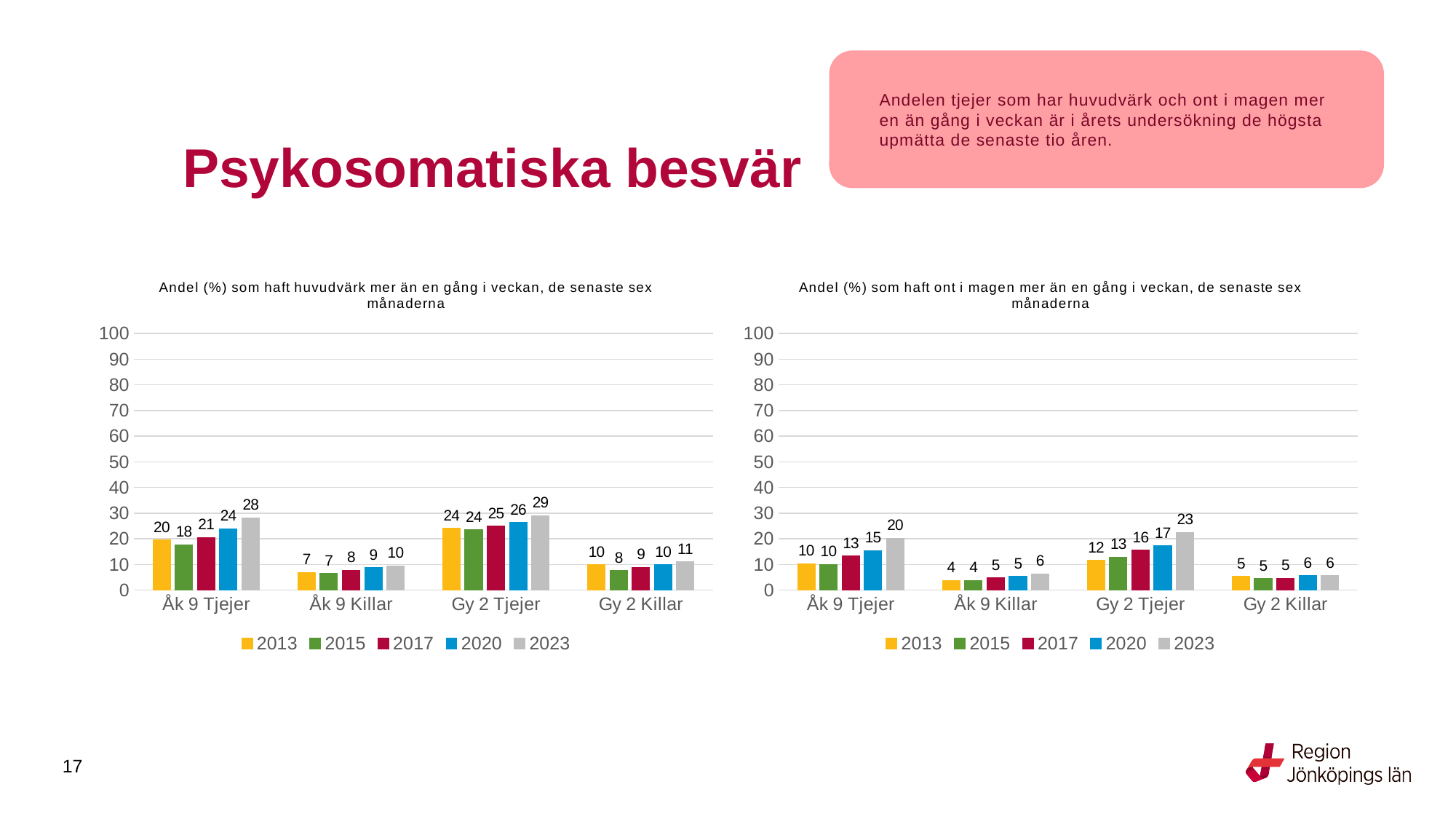
In the left chart (huvudvärk), what is the value for Gy 2 Tjejer in 2023? 29 In the left chart (huvudvärk), which is larger: the 2020 value for Åk 9 Tjejer or the 2020 value for Gy 2 Killar? Åk 9 Tjejer In the right chart (ont i magen), do the values for Gy 2 Tjejer rise or fall from 2013 to 2023? Rise How many series does the legend of the right chart (ont i magen) list? 5 What kind of chart is the left chart (huvudvärk)? Bar chart In the left chart (huvudvärk), which category has the highest value in 2023? Gy 2 Tjejer In the right chart (ont i magen), what is the difference between the 2023 and 2013 values for Gy 2 Tjejer? 11 In the right chart (ont i magen), is the 2023 value for Gy 2 Tjejer greater or less than 20? greater In the right chart (ont i magen), which category has the lowest value in 2013? Åk 9 Killar In the right chart (ont i magen), what is the value for Åk 9 Killar in 2017? 5 In the left chart (huvudvärk), what is the difference between the 2023 and 2013 values for Åk 9 Tjejer? 8 How many categories are shown on the x axis of the left chart (huvudvärk)? 4